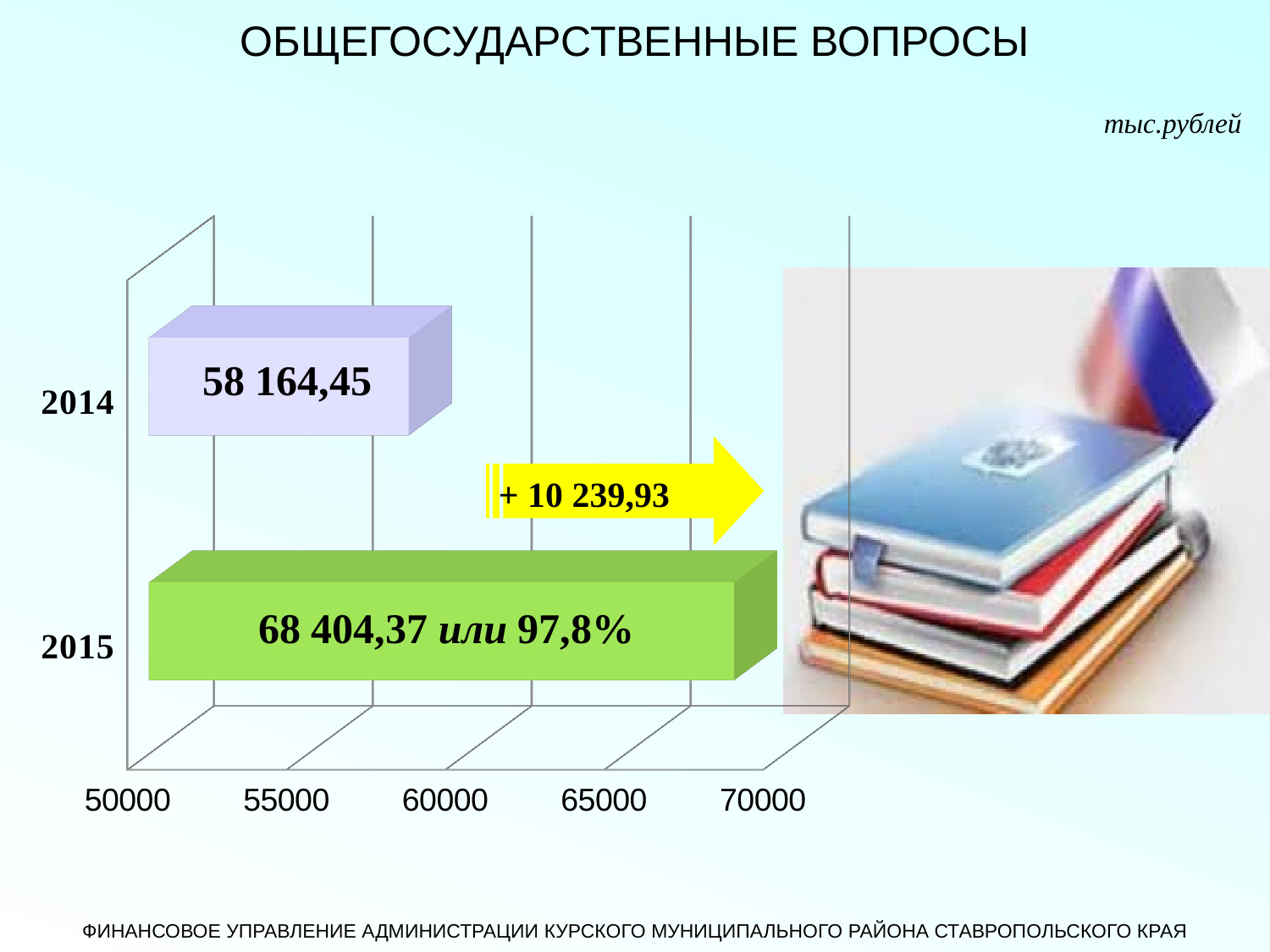
Is the value for 2015 greater or less than 65000? greater Do the values rise or fall from 2014 to 2015? rise Which year has the lower value? 2014 What is the value for 2014? 58 164,45 What unit of measurement is indicated on the slide? тыс.рублей How many years are plotted on the chart? 2 What is the difference between the 2015 and 2014 values, as shown on the arrow? + 10 239,93 What is the value for 2015? 68 404,37 Which year has the higher value? 2015 What percentage is shown next to the 2015 value? 97,8% What kind of chart is shown on the slide? bar chart Is the value for 2014 greater or less than 60000? less